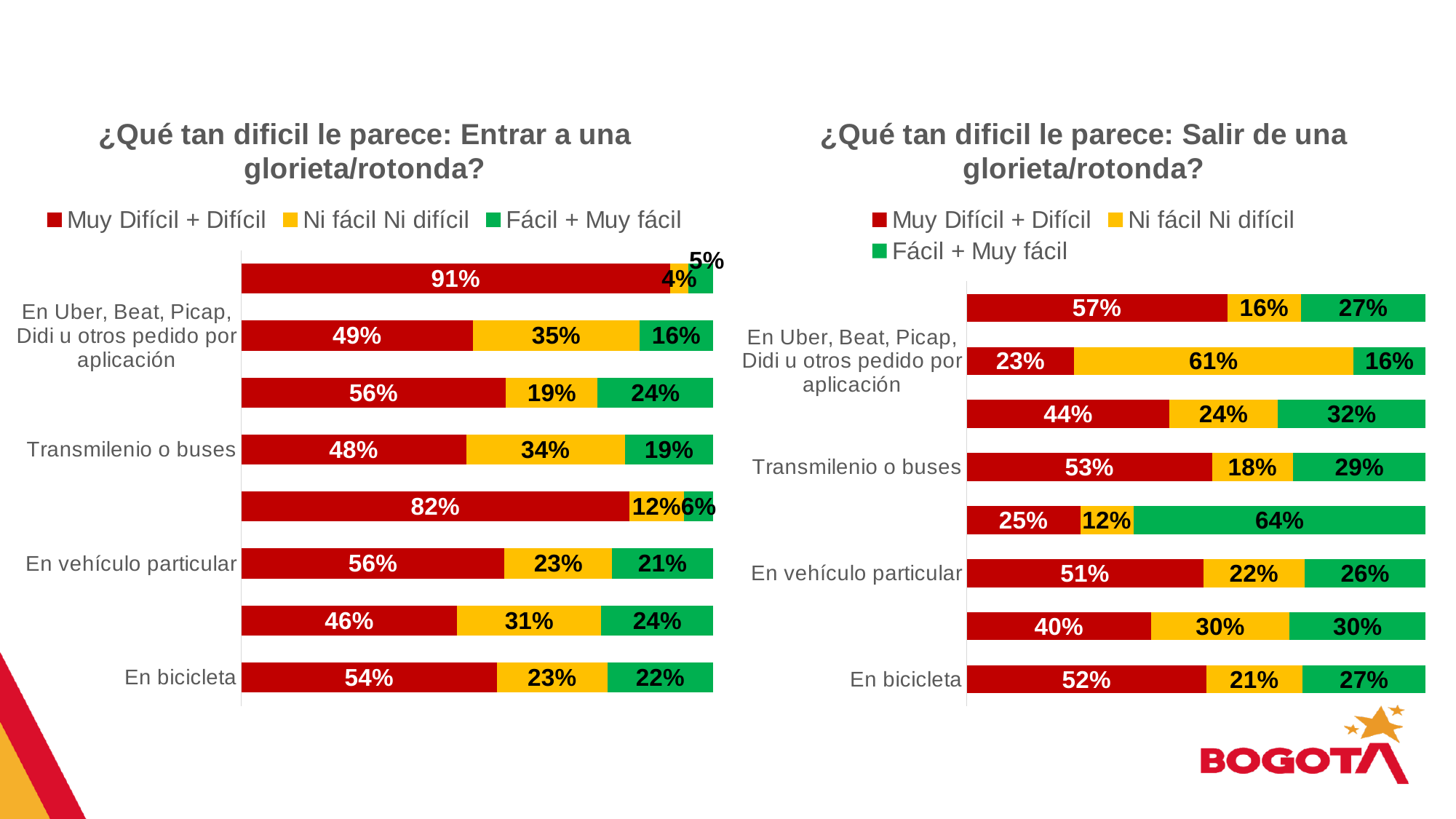
What kind of chart is the left chart (Entrar a una glorieta/rotonda)? Stacked bar chart In the right chart (Salir de una glorieta/rotonda), what is the 'Fácil + Muy fácil' value for 'Transmilenio o buses'? 29% In the left chart (Entrar a una glorieta/rotonda), what is the difference between the 'Muy Difícil + Difícil' and 'Fácil + Muy fácil' values for 'Transmilenio o buses'? 29% What is the title of the right chart? ¿Qué tan dificil le parece: Salir de una glorieta/rotonda? In the left chart (Entrar a una glorieta/rotonda), which colour represents 'Fácil + Muy fácil'? Green In the right chart (Salir de una glorieta/rotonda), what is the 'Ni fácil Ni difícil' value for 'En Uber, Beat, Picap, Didi u otros pedido por aplicación'? 61% In the right chart (Salir de una glorieta/rotonda), what is the total of the stacked bar for 'En bicicleta'? 100% In the right chart (Salir de una glorieta/rotonda), which is larger for 'En vehículo particular': 'Ni fácil Ni difícil' or 'Fácil + Muy fácil'? Fácil + Muy fácil In the left chart (Entrar a una glorieta/rotonda), what is the 'Muy Difícil + Difícil' value for 'En bicicleta'? 54% In the left chart (Entrar a una glorieta/rotonda), what is the 'Ni fácil Ni difícil' value for 'En vehículo particular'? 23% How many bars are plotted in the left chart (Entrar a una glorieta/rotonda)? 8 How many series does the legend of the right chart (Salir de una glorieta/rotonda) list? 3